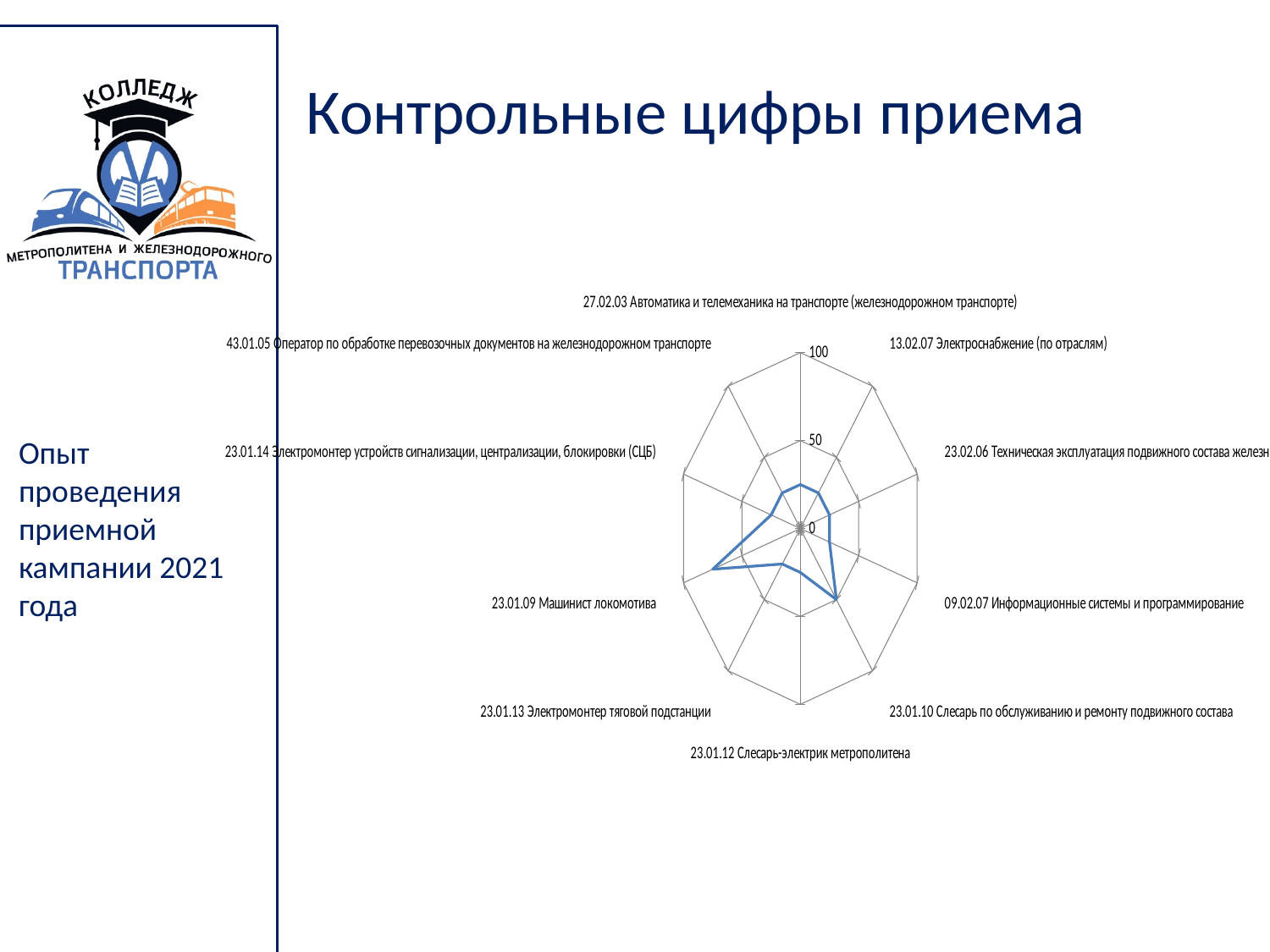
Is the value for 23.01.13 Электромонтер тяговой подстанции greater or less than 50? less What is the maximum value shown on the radar chart's axis scale? 100 How many categories (specialties) are plotted on the radar chart? 10 What is the title of the slide containing the chart? Контрольные цифры приема Is the value for 23.01.09 Машинист локомотива greater or less than 100? less Which is larger: the value for 23.01.09 Машинист локомотива or the value for 27.02.03 Автоматика и телемеханика на транспорте? 23.01.09 Машинист локомотива Which category has the highest value on the radar chart? 23.01.09 Машинист локомотива Is the value for 27.02.03 Автоматика и телемеханика на транспорте greater or less than 50? less What kind of chart is shown on the slide? radar chart Which is larger: the value for 23.01.09 Машинист локомотива or the value for 23.01.12 Слесарь-электрик метрополитена? 23.01.09 Машинист локомотива